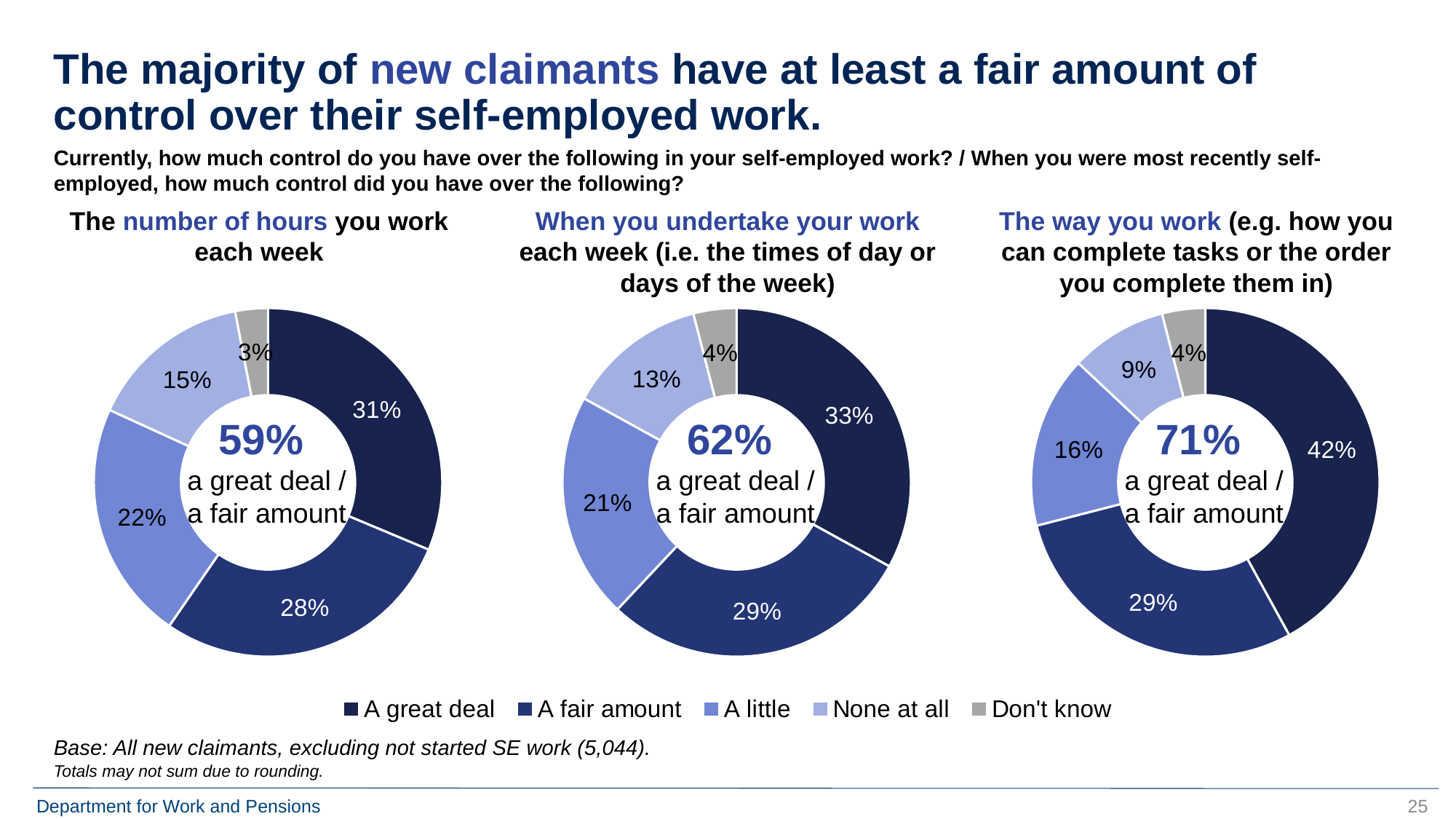
In the chart 'When you undertake your work each week', what percentage answered 'None at all'? 13% In the chart 'When you undertake your work each week', what is the difference between the 'A great deal' and 'A fair amount' shares? 4 percentage points In the chart 'The way you work', what is the difference between the 'A great deal' share and the 'A little' share? 26 percentage points How many response categories does the legend list? 5 In the chart 'The number of hours you work each week', which response category has the smallest share? Don't know In the chart 'When you undertake your work each week', what combined percentage said 'a great deal / a fair amount'? 62% In the chart 'The number of hours you work each week', what percentage of new claimants said they have 'A great deal' of control? 31% In the chart 'The way you work', which response category has the largest share? A great deal What is the base size stated for the charts on this slide? 5,044 What kind of chart is used to show the responses on this slide? Pie (donut) chart In the chart 'The way you work', what percentage answered 'A little'? 16% Which is larger: the 'A little' share in 'The number of hours you work each week' or the 'A little' share in 'The way you work'? The number of hours you work each week